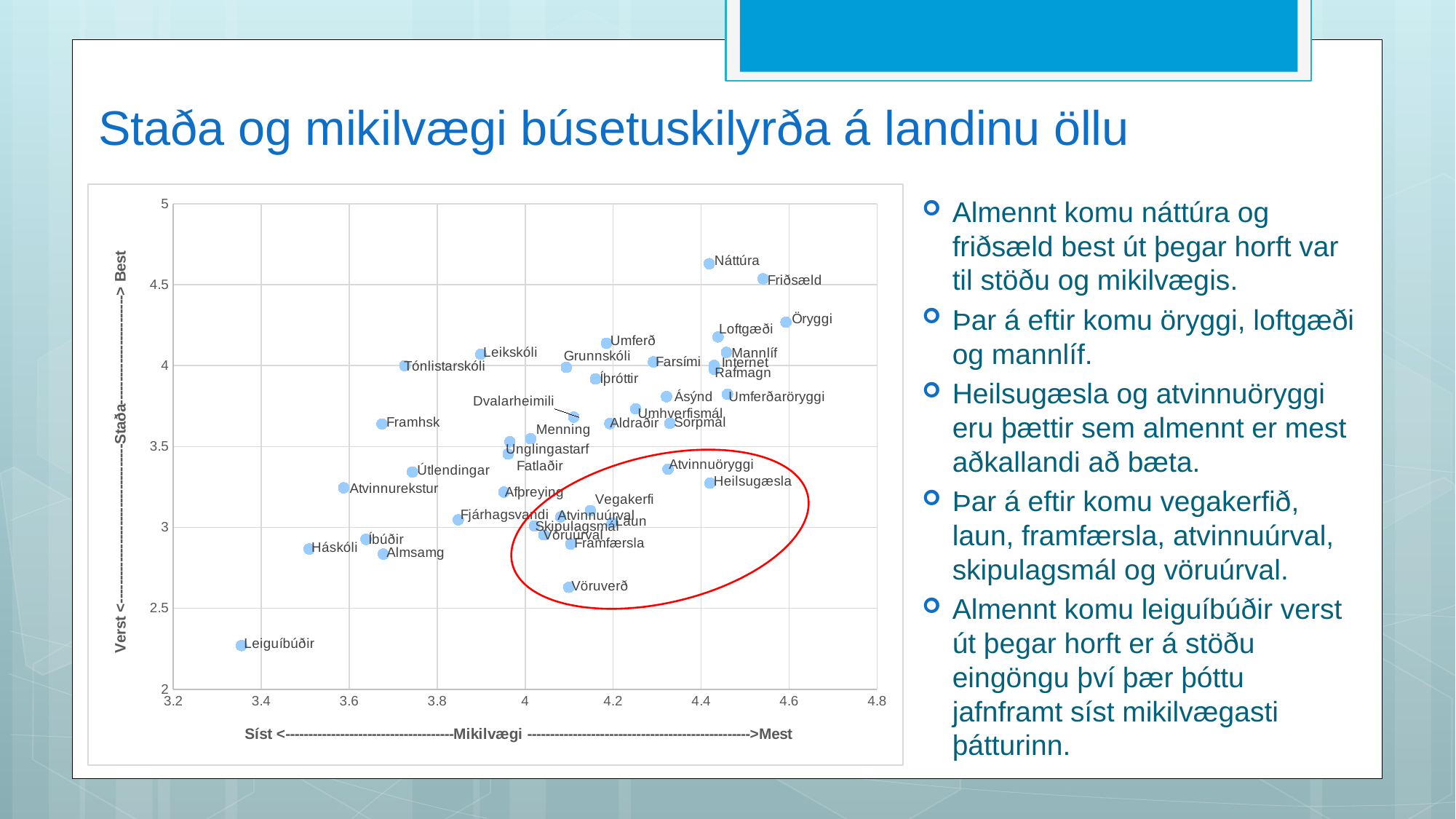
Is the Staða value for Náttúra greater or less than 4.5? greater Is the Staða value for Vöruverð greater or less than 3? less Is the Staða value for Leiguíbúðir greater or less than 2.5? less Which has the higher Staða value, Náttúra or Vöruverð? Náttúra What kind of chart is shown on the slide? scatter chart Which point has the lowest Mikilvægi (horizontal axis) value? Leiguíbúðir What is the label of the horizontal axis? Síst <---Mikilvægi --->Mest Which point has the highest Staða (vertical axis) value? Náttúra Which point has the lowest Staða (vertical axis) value? Leiguíbúðir